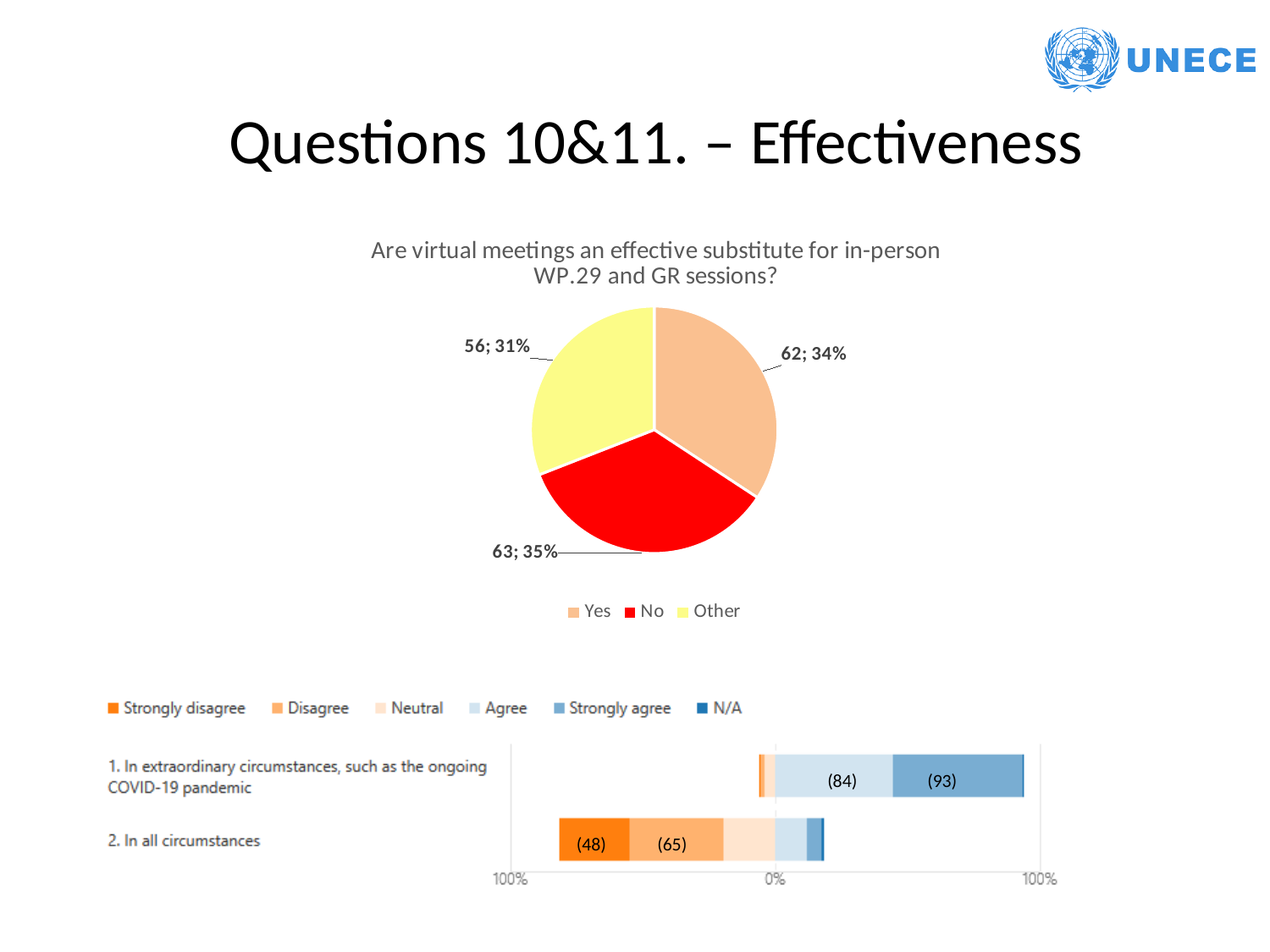
On the pie chart, what percentage share does the "Other" slice have? 31% On the pie chart, what percentage share does the "Yes" slice have? 34% On the lower bar chart, how many series does the legend list? 6 On the lower bar chart, what is the "Strongly agree" value for "1. In extraordinary circumstances, such as the ongoing COVID-19 pandemic"? (93) On the pie chart, how many respondents answered "No"? 63 What kind of chart is the lower chart on the slide? Bar chart On the lower bar chart, which is larger for "2. In all circumstances": "Strongly disagree" or "Disagree"? Disagree On the pie chart, how many slices are there? 3 On the lower bar chart, what is the "Disagree" value for "2. In all circumstances"? (65) On the pie chart, which response has the smallest slice? Other On the pie chart, which colour represents "No"? Red On the pie chart, what is the difference between the number of "No" and "Other" responses? 7